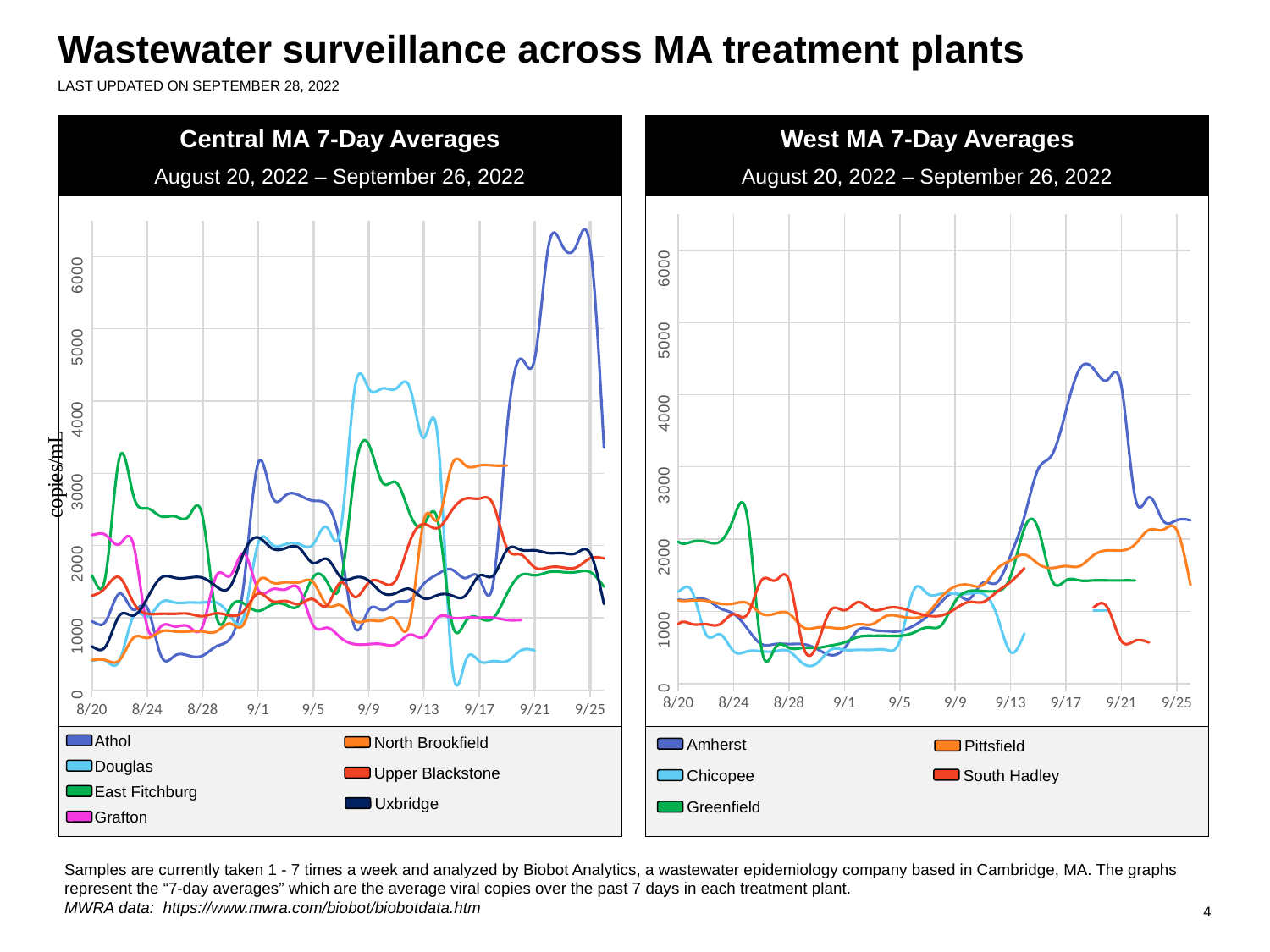
In the Central MA 7-Day Averages chart, is the peak value for Douglas around 9/9 greater or less than 4000? greater In the West MA 7-Day Averages chart, which series reaches the highest value? Amherst How many series does the legend of the West MA 7-Day Averages chart list? 5 In the West MA 7-Day Averages chart, is the peak value for Amherst around 9/18 greater or less than 4000? greater What date range is shown in the subtitle of the West MA 7-Day Averages chart? August 20, 2022 – September 26, 2022 In the West MA 7-Day Averages chart, does the Amherst line rise or fall between 9/9 and 9/17? rise What kind of chart is the Central MA 7-Day Averages chart? line chart In the Central MA 7-Day Averages chart, which series reaches the highest value? Athol In the Central MA 7-Day Averages chart, is the peak value for Athol around 9/23 greater or less than 6000? greater What is the y-axis label on the Central MA 7-Day Averages chart? copies/mL How many series does the legend of the Central MA 7-Day Averages chart list? 7